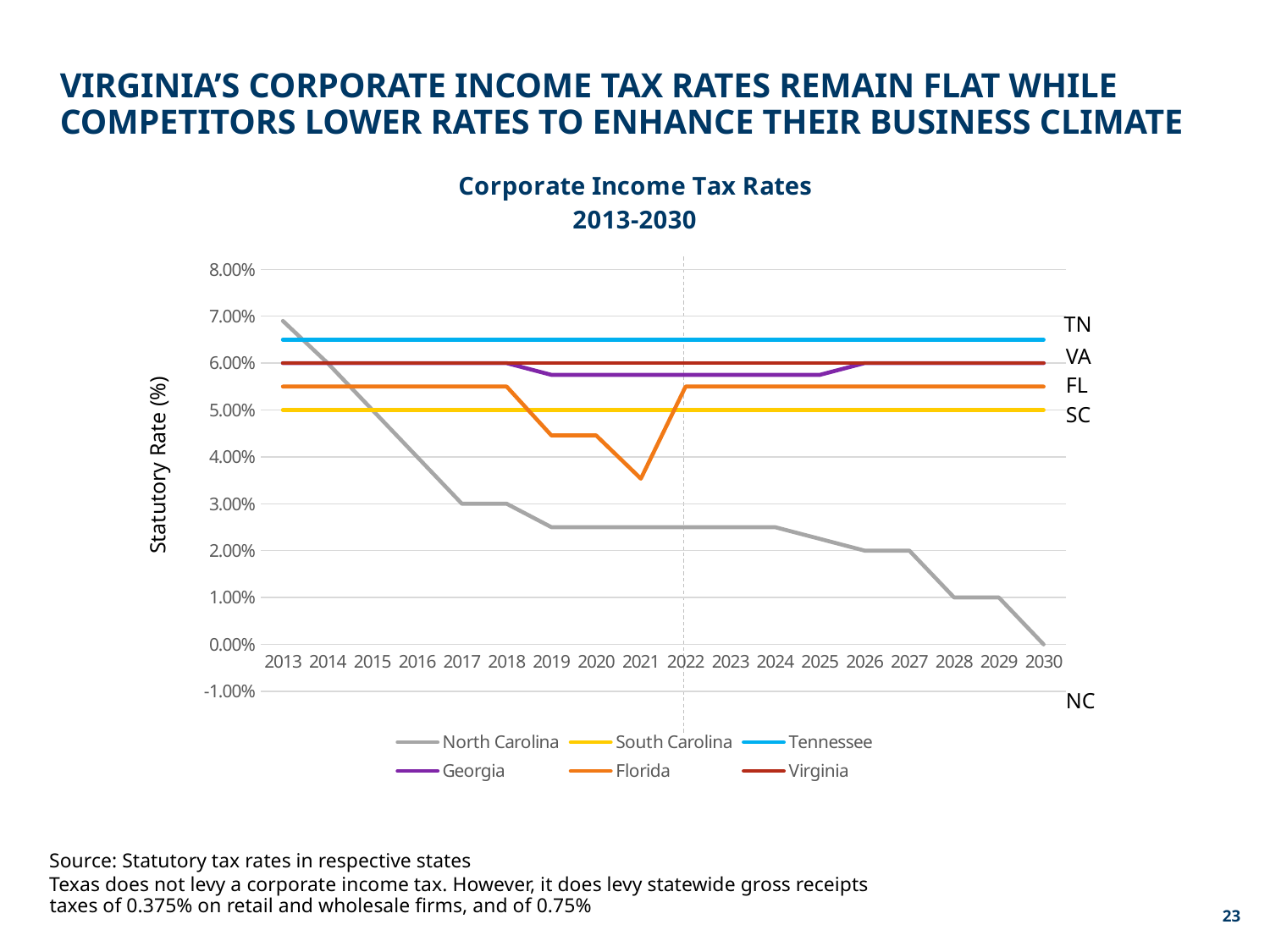
Does the North Carolina line rise or fall from 2013 to 2030? Fall How many series does the legend list? 6 Which state has the lowest statutory rate in 2029? North Carolina What is the statutory rate for North Carolina in 2030? 0.00% What kind of chart is shown on the slide? Line chart What is the statutory rate for Virginia in 2020? 6.00% Which state has the highest statutory rate in 2025? Tennessee Is the value for Florida in 2021 greater or less than 4.00%? less Is the value for Tennessee in 2022 greater or less than 6.00%? greater What is the statutory rate for North Carolina in 2017? 3.00% How many years are shown on the x axis? 18 What is the statutory rate for South Carolina in 2025? 5.00%